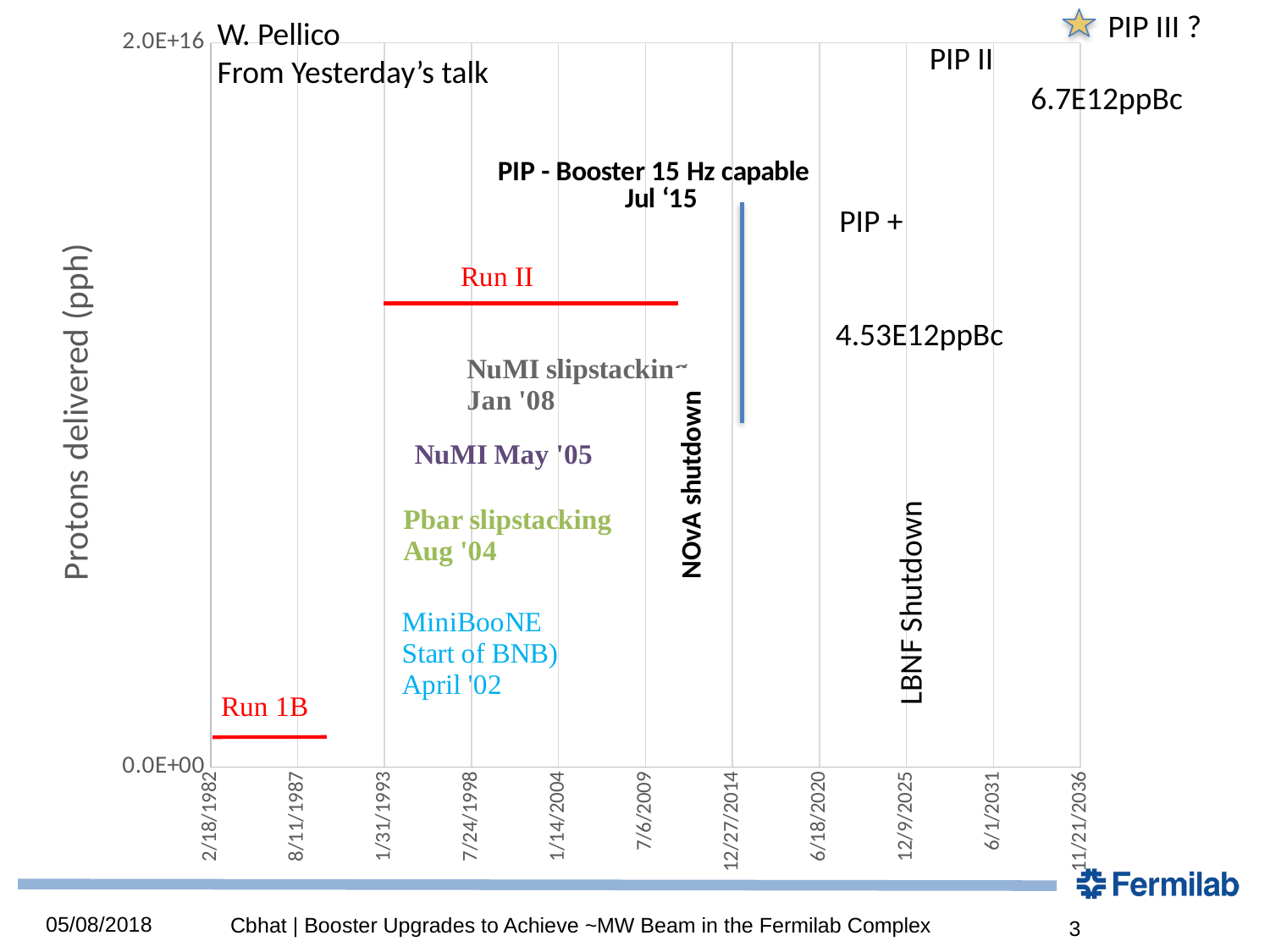
What date is annotated for MiniBooNE (Start of BNB) on the chart? April '02 How many date labels are shown along the horizontal axis? 11 What date is annotated for NuMI on the chart? May '05 What is the highest value shown on the vertical axis? 2.0E+16 What date is annotated for Pbar slipstacking on the chart? Aug '04 What protons-per-Booster-cycle value is annotated below PIP II on the chart? 6.7E12ppBc What date is annotated for PIP - Booster 15 Hz capable on the chart? Jul '15 What protons-per-Booster-cycle value is annotated below PIP + on the chart? 4.53E12ppBc What date is annotated for NuMI slipstacking on the chart? Jan '08 Which run appears earlier along the horizontal axis, Run 1B or Run II? Run 1B Which run is marked at a higher level on the chart, Run 1B or Run II? Run II What is the label on the vertical axis of the chart? Protons delivered (pph)